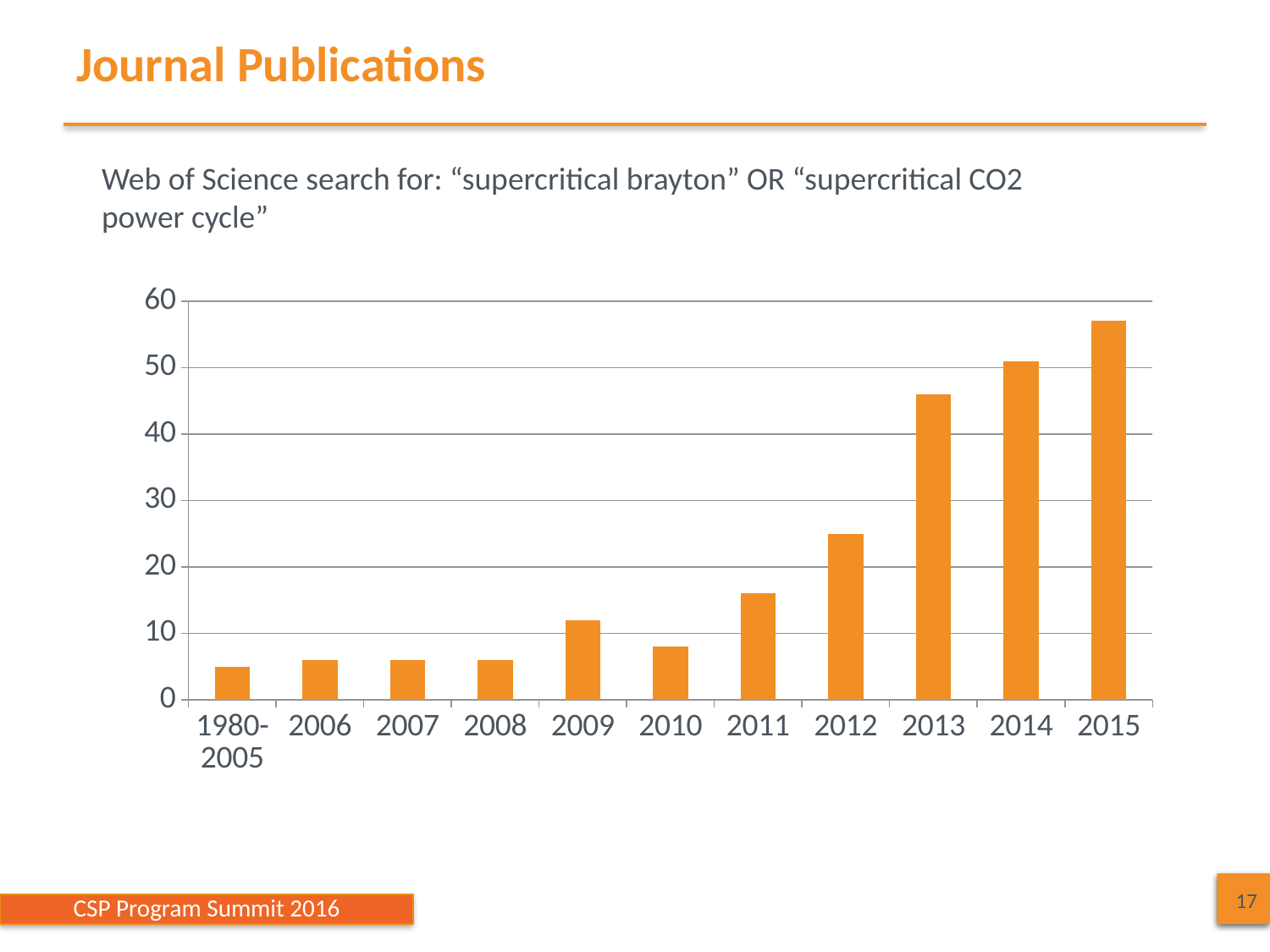
What search terms does the slide say were used in the Web of Science search? "supercritical brayton" OR "supercritical CO2 power cycle" What kind of chart is shown on the slide? bar chart Is the value for 2015 greater or less than 50? greater Is the value for 2012 greater or less than 30? less Is the value for 2010 greater or less than 10? less Which is larger, the value for 2014 or the value for 2012? 2014 Do the values generally rise or fall from 2010 to 2015? rise Which category has the highest number of journal publications? 2015 How many categories are shown on the x axis of the chart? 11